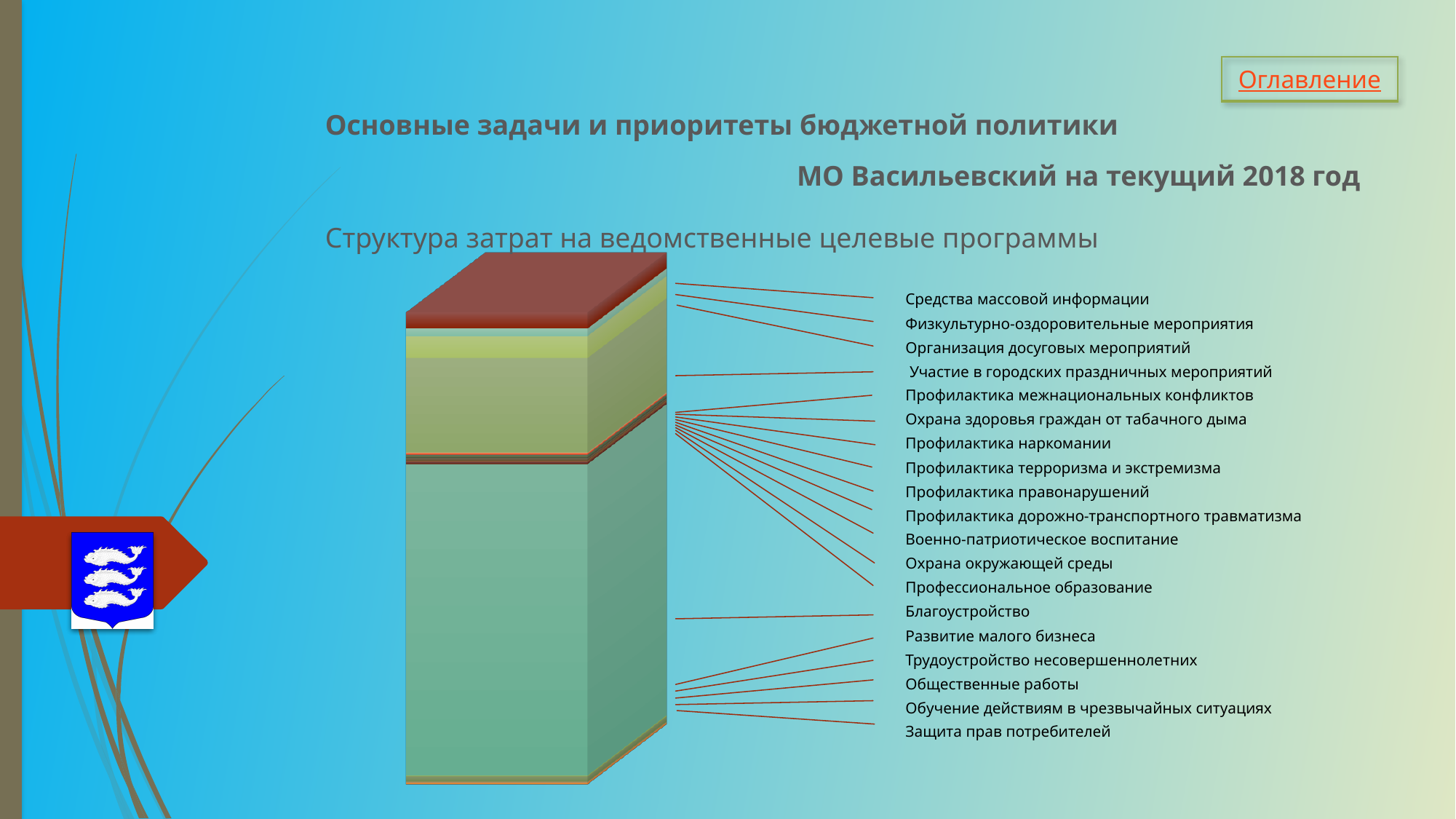
Which segment is larger: Благоустройство or Организация досуговых мероприятий? Благоустройство Which programme accounts for the largest segment of the stacked bar? Благоустройство Which programme's segment is at the very top of the stacked bar? Средства массовой информации Which segment is larger: Благоустройство or Средства массовой информации? Благоустройство What is the title of the chart on the slide? Структура затрат на ведомственные целевые программы Which programme label is listed last (at the bottom) in the list next to the bar? Защита прав потребителей How many bars does the chart contain? 1 Which segment is larger: Средства массовой информации or Защита прав потребителей? Средства массовой информации How many categories (programme labels) are listed next to the stacked bar? 19 What kind of chart is shown on the slide? Stacked bar chart